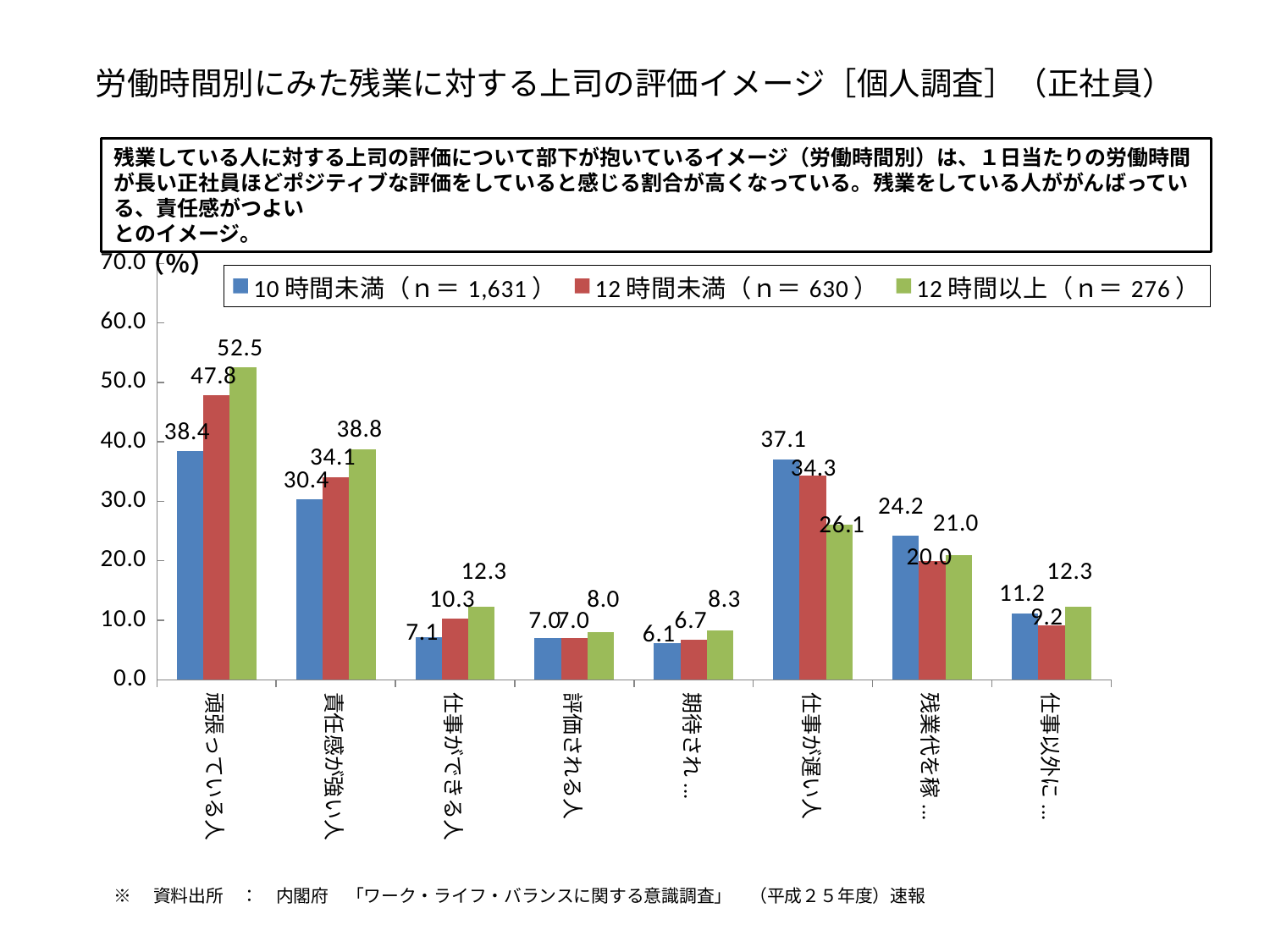
What is the value for 12時間以上 in the 頑張っている人 category? 52.5 Is the value for 12時間未満 in the 頑張っている人 category greater or less than 40.0? greater How many categories are shown on the x axis? 8 How many series does the legend list? 3 What kind of chart is shown on the slide? bar chart What is the difference between the 10時間未満 and 12時間以上 values for 仕事が遅い人? 11.0 What is the value for 10時間未満 in the 仕事が遅い人 category? 37.1 For 責任感が強い人, which is larger: the 10時間未満 value or the 12時間未満 value? 12時間未満 What is the value for 12時間未満 in the 責任感が強い人 category? 34.1 In the 仕事が遅い人 category, which series has the lowest value? 12時間以上 What is the difference between the 12時間以上 and 10時間未満 values for 頑張っている人? 14.1 Which category has the highest value for the 12時間以上 series? 頑張っている人